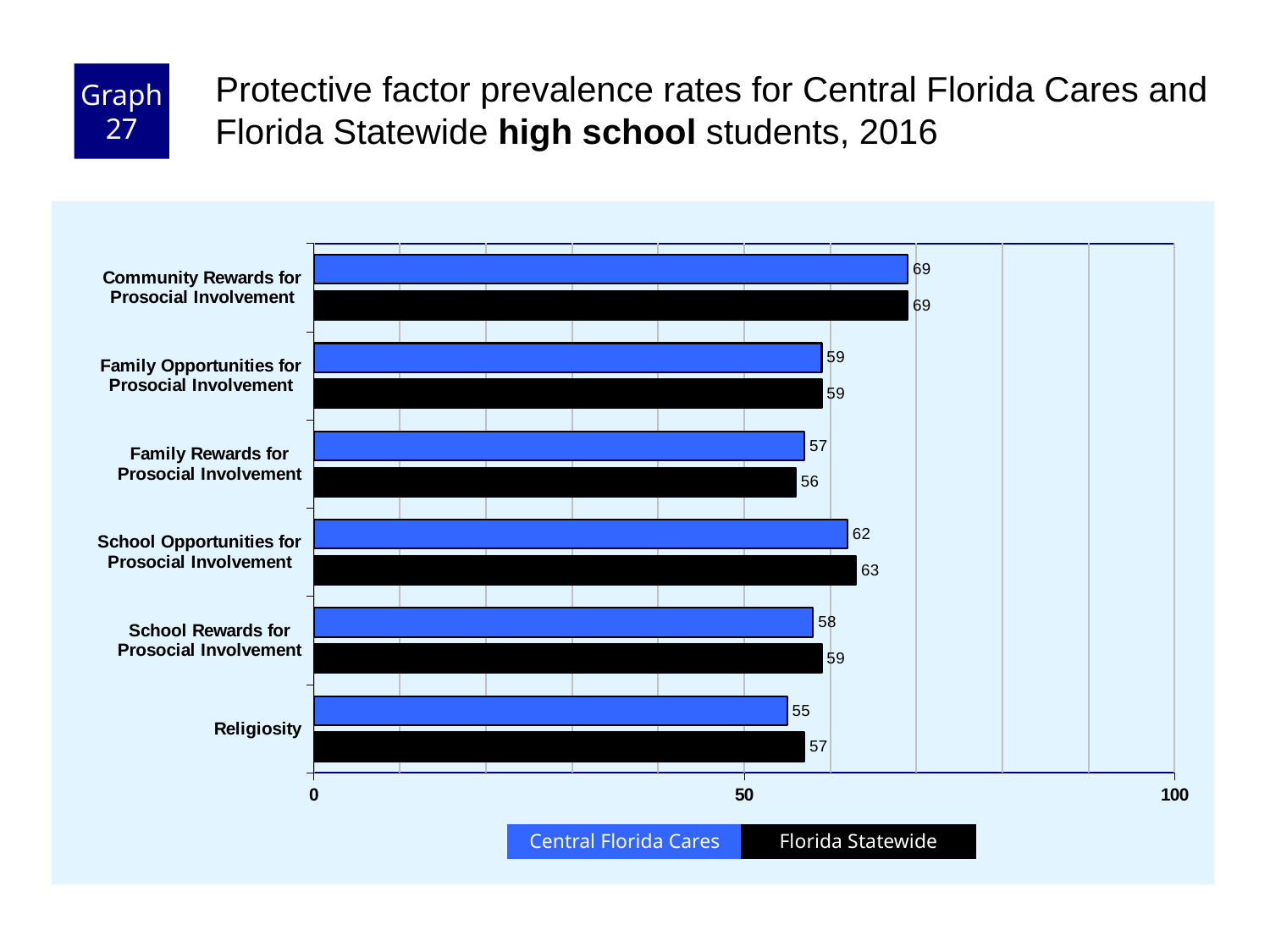
Which category has the lowest Central Florida Cares value? Religiosity How many series does the legend list? 2 What is the Florida Statewide value for Religiosity? 57 Is the Florida Statewide value for Family Rewards for Prosocial Involvement greater or less than 50? greater For School Rewards for Prosocial Involvement, which is larger: the Central Florida Cares value or the Florida Statewide value? Florida Statewide What kind of chart is shown on the slide? bar chart What is the Central Florida Cares value for Family Rewards for Prosocial Involvement? 57 What is the Central Florida Cares value for Community Rewards for Prosocial Involvement? 69 Which category has the highest Central Florida Cares value? Community Rewards for Prosocial Involvement What is the Florida Statewide value for School Opportunities for Prosocial Involvement? 63 What is the difference between the Central Florida Cares and Florida Statewide values for Religiosity? 2 How many categories are shown on the chart? 6